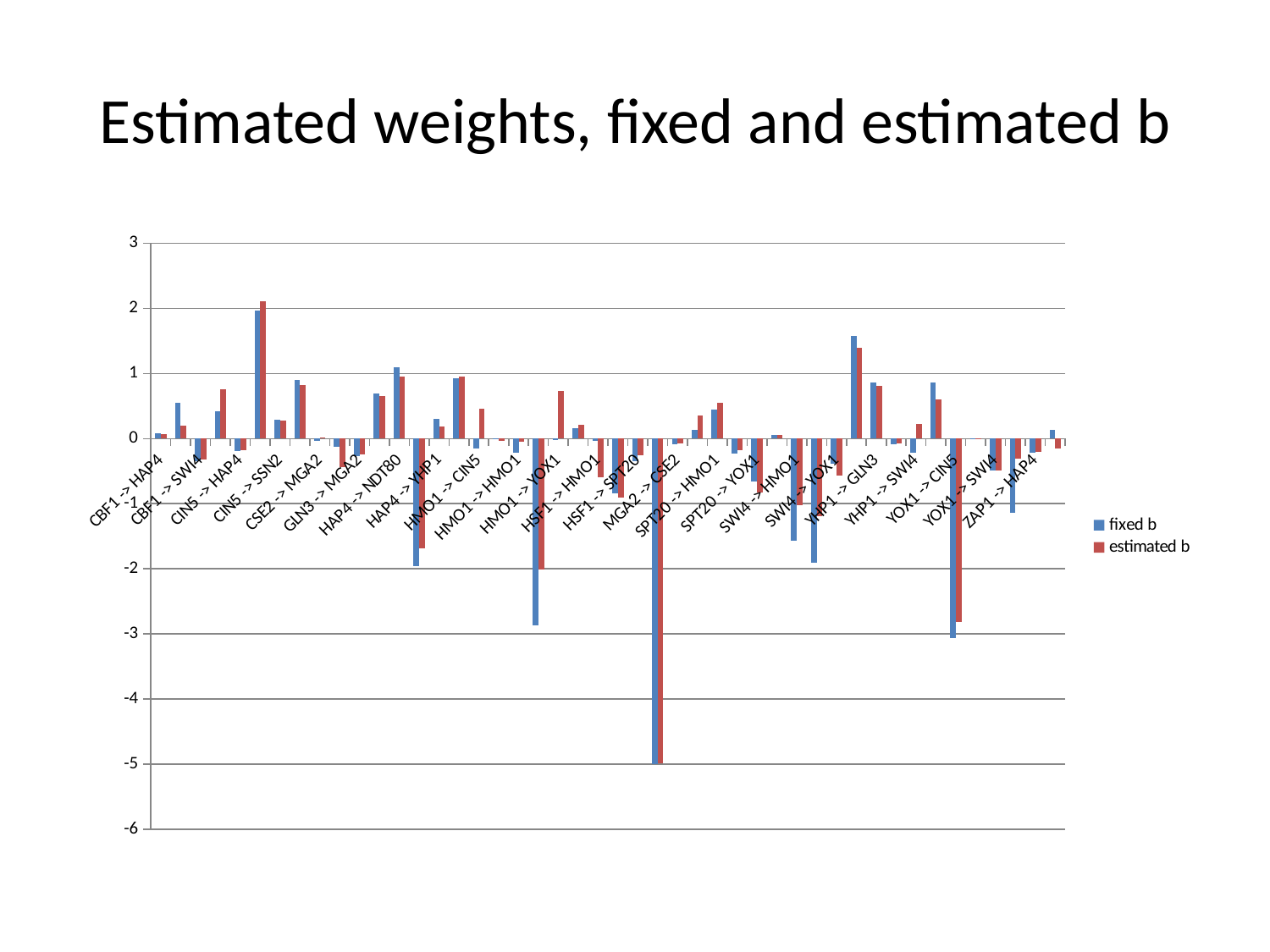
Is the lowest value plotted in the chart greater or less than -4? less What is the title of the slide's chart? Estimated weights, fixed and estimated b What are the two series named in the legend? fixed b and estimated b Is the highest value plotted in the chart greater or less than 1? greater Is the highest value plotted in the chart greater or less than 3? less What kind of chart is shown on the slide? bar chart How many series does the legend list? 2